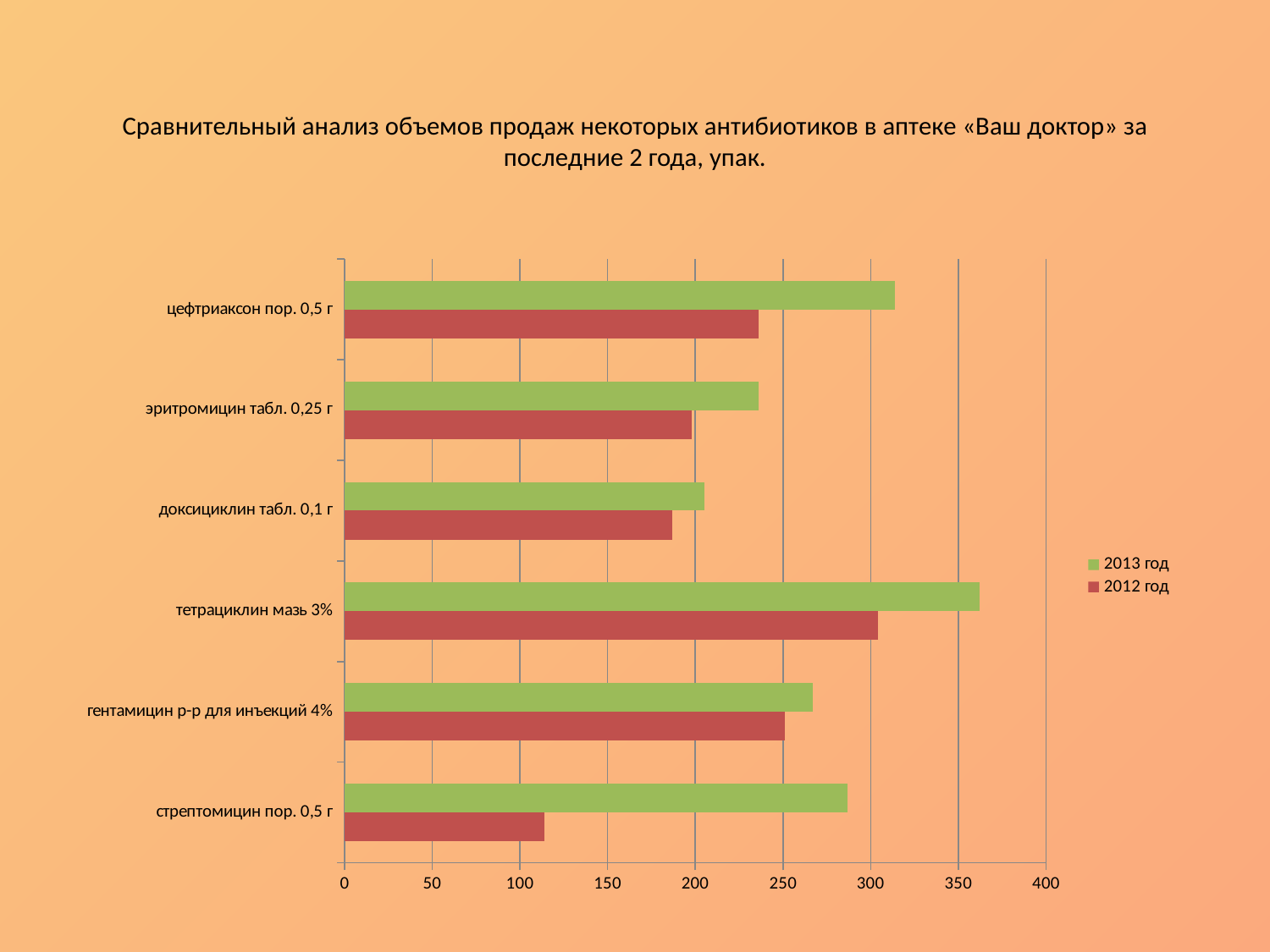
Is the value for тетрациклин мазь 3% in 2013 год greater or less than 350? greater Which series is shown in green in the legend? 2013 год Which category has the lowest value for 2012 год? стрептомицин пор. 0,5 г Which category has the highest value for 2013 год? тетрациклин мазь 3% What kind of chart is shown on the slide? bar chart Which category has the highest value for 2012 год? тетрациклин мазь 3% How many series does the legend list? 2 Which category has the lowest value for 2013 год? доксициклин табл. 0,1 г How many antibiotic categories are plotted on the chart? 6 Is the value for стрептомицин пор. 0,5 г in 2012 год greater or less than 150? less For стрептомицин пор. 0,5 г, which series has the larger value, 2013 год or 2012 год? 2013 год Is the value for доксициклин табл. 0,1 г in 2012 год greater or less than 200? less